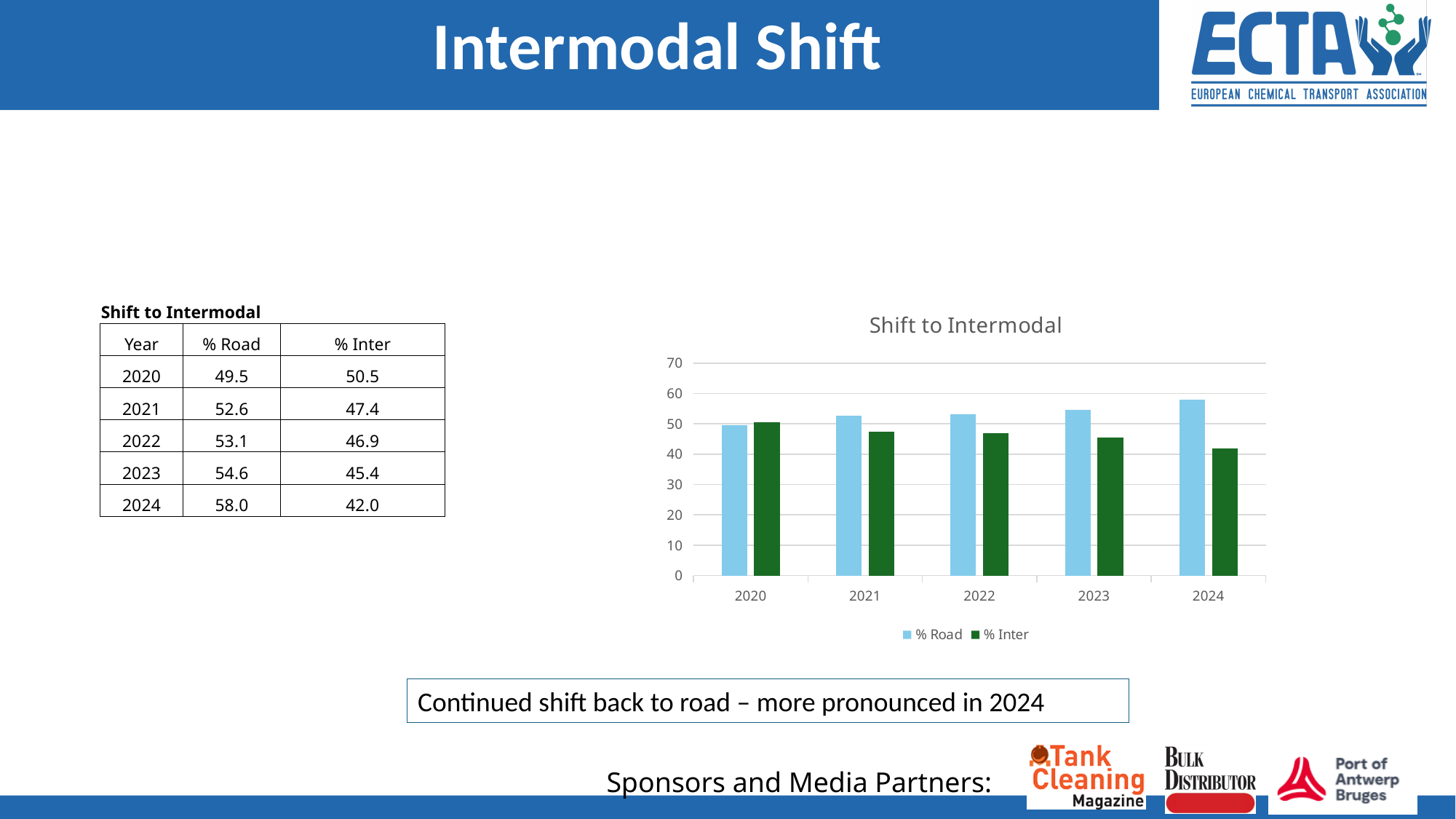
Which year has the highest % Road value? 2024 Which year has the lowest % Inter value? 2024 In 2020, which is larger, % Road or % Inter? % Inter What is the difference between % Road and % Inter in 2024? 16.0 Does the % Road series rise or fall from 2020 to 2024? rise What type of chart is shown on the slide? bar chart What is the % Road value for 2024? 58.0 How many years are shown on the x axis of the chart? 5 What is the title of the chart? Shift to Intermodal Is the % Inter value for 2024 greater or less than 50? less What is the % Inter value for 2020? 50.5 How many series does the chart legend list? 2